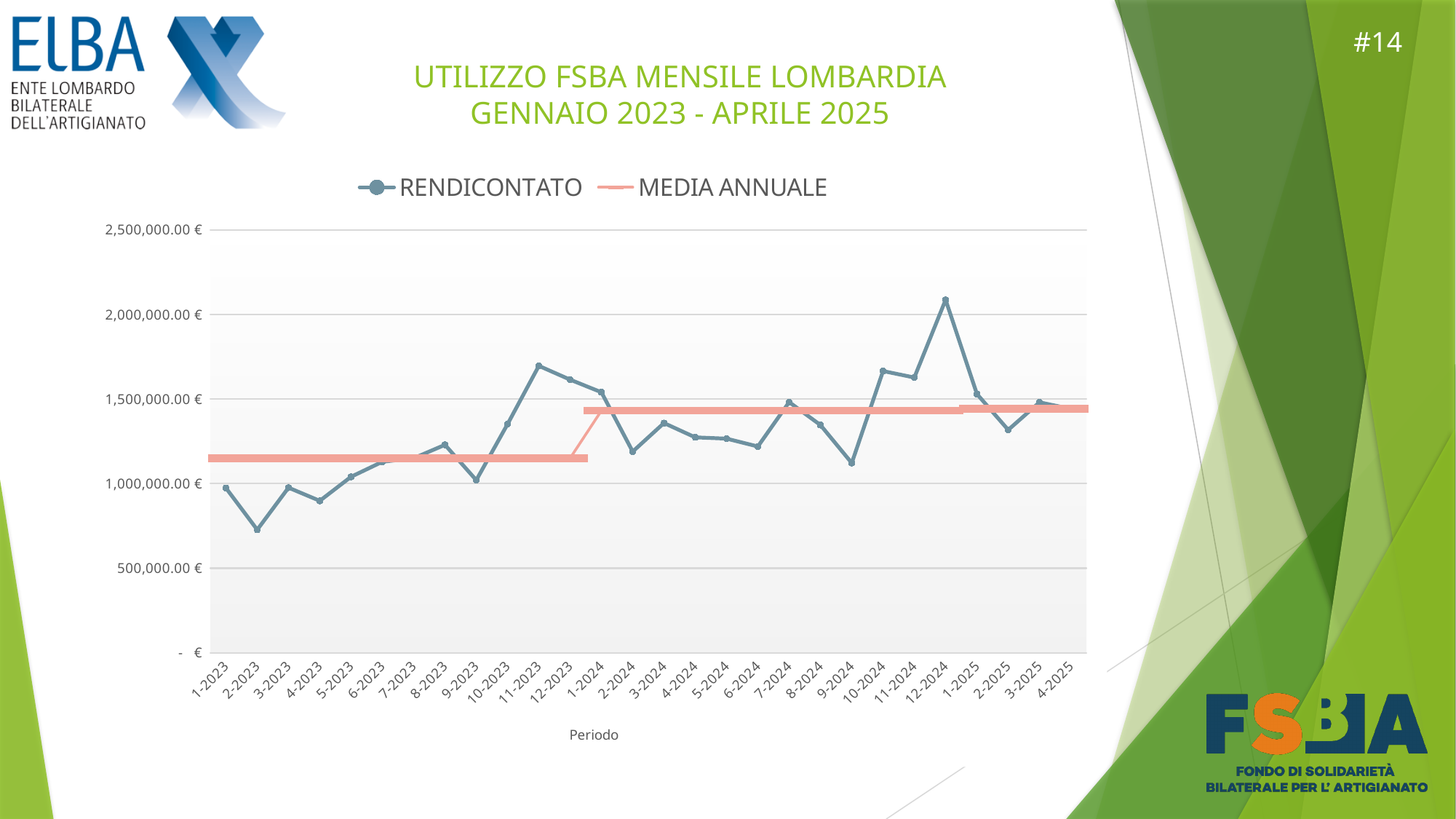
How many monthly periods are plotted along the x axis? 28 Is the RENDICONTATO value for 2-2023 greater or less than 1,000,000.00 €? less Is the RENDICONTATO value for 12-2024 greater or less than 2,000,000.00 €? greater Is the RENDICONTATO value for 9-2024 greater or less than 1,500,000.00 €? less In which period does the RENDICONTATO series reach its lowest value? 2-2023 What kind of chart is shown on the slide? line chart What is the label of the x axis? Periodo Which period has the larger RENDICONTATO value, 9-2023 or 10-2023? 10-2023 In which period does the RENDICONTATO series reach its highest value? 12-2024 Does the RENDICONTATO series rise or fall from 12-2024 to 2-2025? fall How many series does the legend list? 2